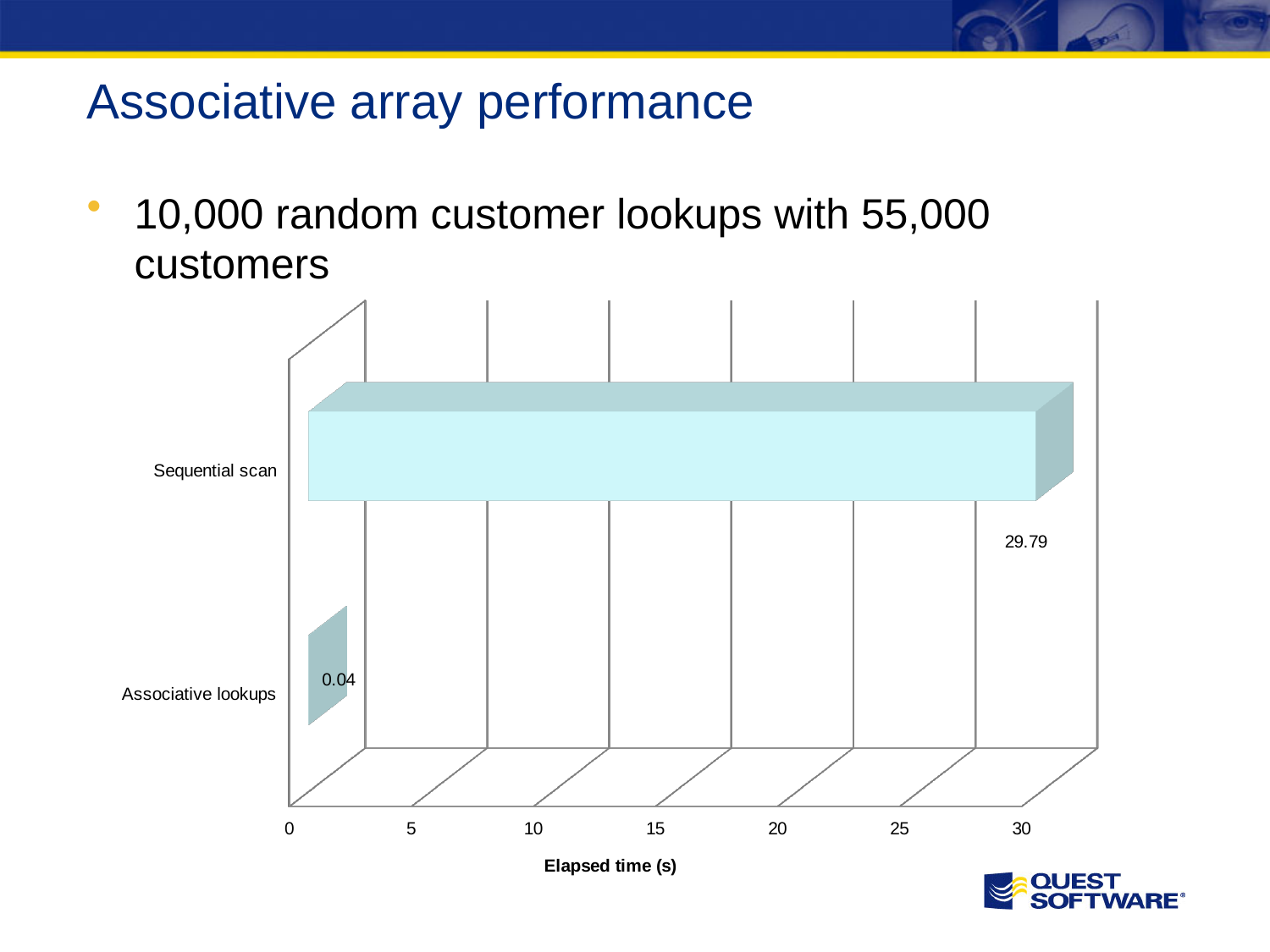
Is the value for Sequential scan greater or less than 25? greater What is the label of the horizontal axis? Elapsed time (s) Which has a larger elapsed time, Sequential scan or Associative lookups? Sequential scan What kind of chart is shown on the slide? Bar chart Which category has the highest elapsed time? Sequential scan What is the maximum value shown on the horizontal axis? 30 Which category has the lowest elapsed time? Associative lookups How many categories are shown in the chart? 2 Is the value for Associative lookups greater or less than 5? less What is the difference in elapsed time between Sequential scan and Associative lookups? 29.75 What is the elapsed time for Sequential scan? 29.79 What is the elapsed time for Associative lookups? 0.04